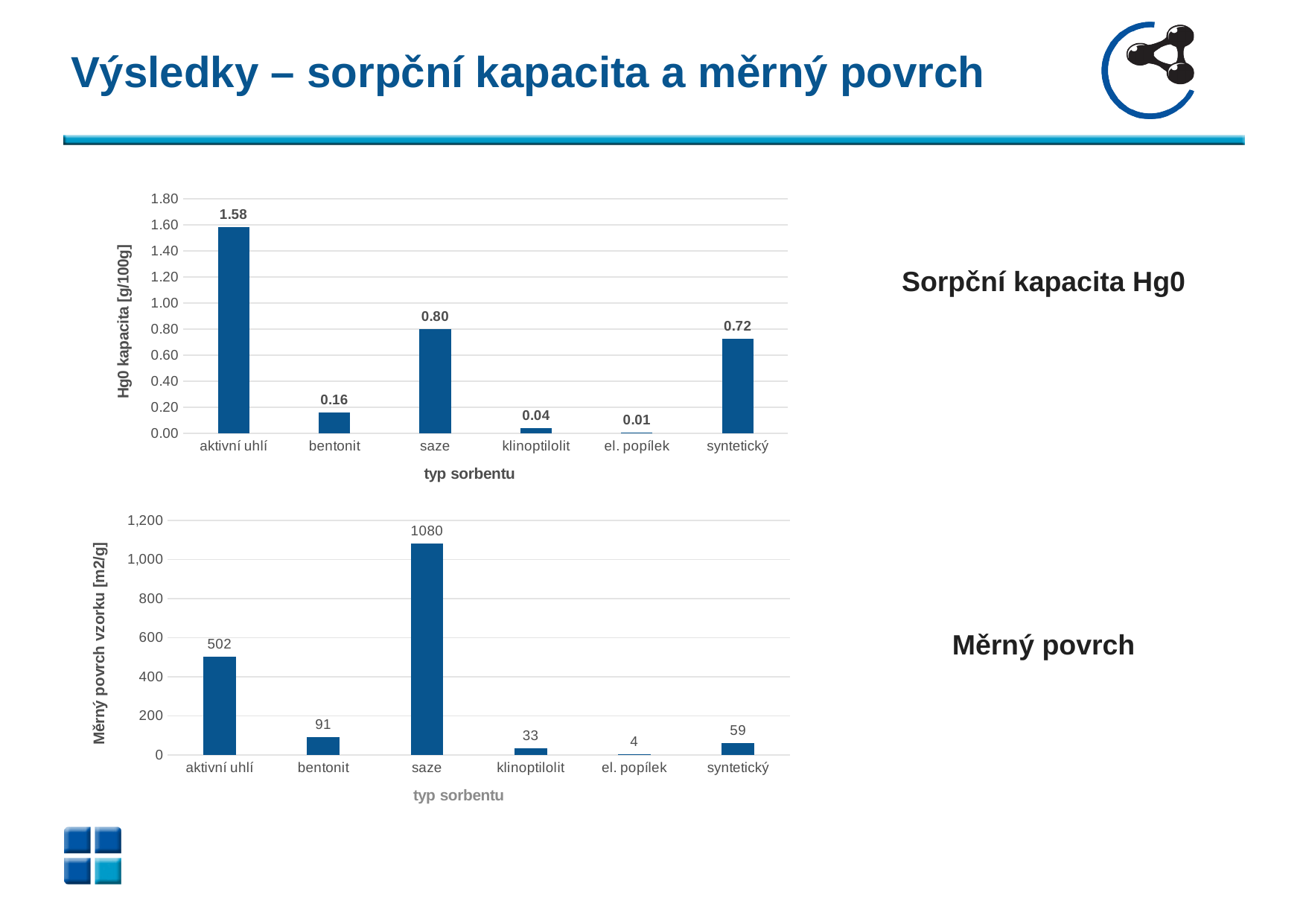
In the bottom chart (Měrný povrch), what is the value for el. popílek? 4 What kind of chart is the bottom chart (Měrný povrch)? bar chart What is the y-axis label of the top chart (Sorpční kapacita Hg0)? Hg0 kapacita [g/100g] In the top chart (Sorpční kapacita Hg0), what is the difference between the values for saze and syntetický? 0.08 In the bottom chart (Měrný povrch), which sorbent type has the highest specific surface area? saze In the bottom chart (Měrný povrch), what is the specific surface area for saze? 1080 In the top chart (Sorpční kapacita Hg0), what is the Hg0 capacity for aktivní uhlí? 1.58 In the top chart (Sorpční kapacita Hg0), which sorbent type has the lowest Hg0 capacity? el. popílek In the bottom chart (Měrný povrch), which is larger, the value for bentonit or the value for syntetický? bentonit In the bottom chart (Měrný povrch), what is the difference between the values for saze and aktivní uhlí? 578 In the top chart (Sorpční kapacita Hg0), which is larger, the value for bentonit or the value for klinoptilolit? bentonit In the top chart (Sorpční kapacita Hg0), how many sorbent types are shown on the x axis? 6